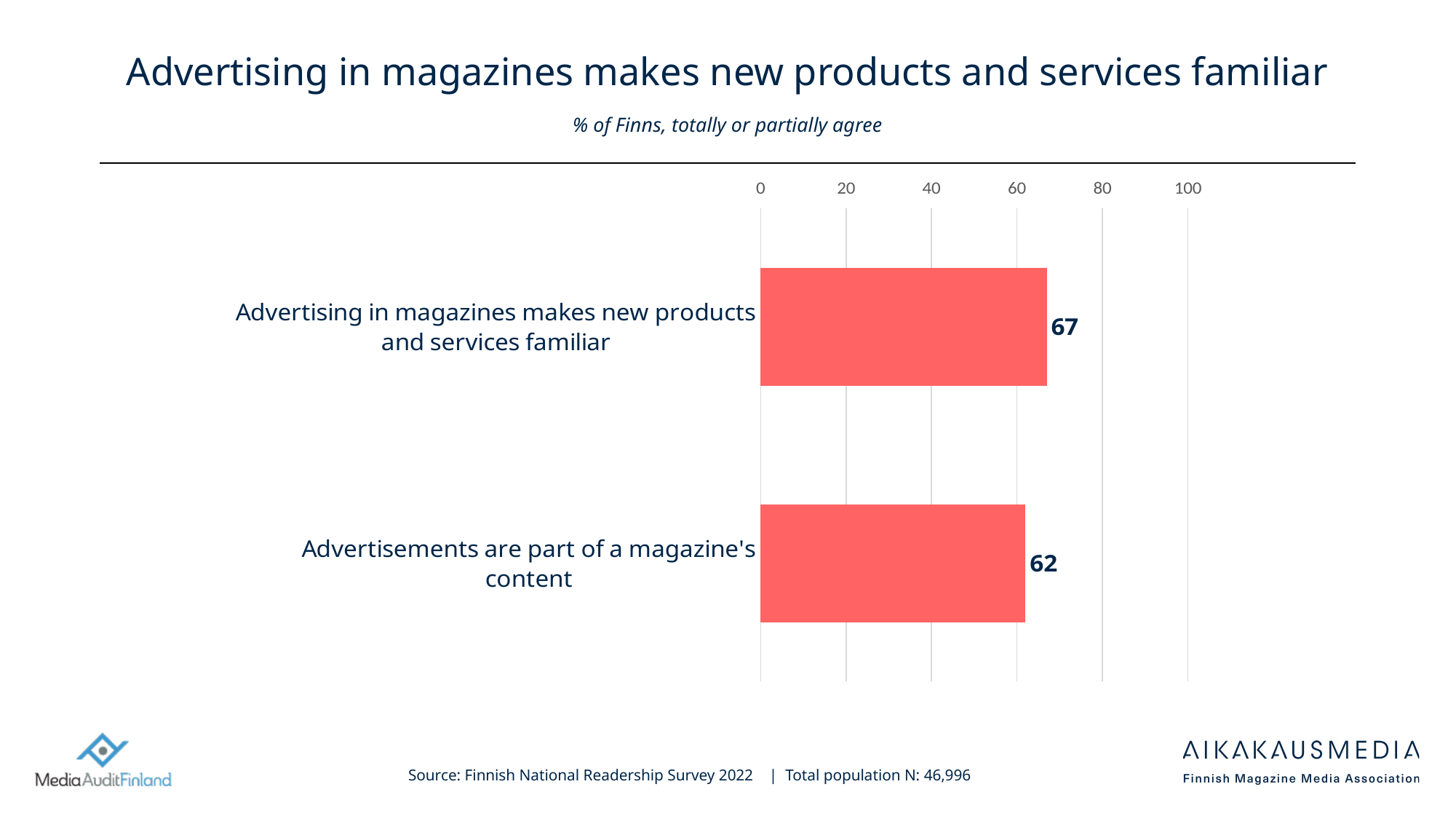
What is the title of the slide? Advertising in magazines makes new products and services familiar Is the value for "Advertisements are part of a magazine's content" greater or less than 80? less What is the maximum value shown on the chart's axis? 100 Which is larger: the value for "Advertising in magazines makes new products and services familiar" or for "Advertisements are part of a magazine's content"? Advertising in magazines makes new products and services familiar What kind of chart is shown on the slide? bar chart Which category has the lowest value? Advertisements are part of a magazine's content How many categories are shown in the chart? 2 What is the value for "Advertisements are part of a magazine's content"? 62 Is the value for "Advertising in magazines makes new products and services familiar" greater or less than 60? greater What is the value for "Advertising in magazines makes new products and services familiar"? 67 What is the difference between the values for "Advertising in magazines makes new products and services familiar" and "Advertisements are part of a magazine's content"? 5 Which category has the highest value? Advertising in magazines makes new products and services familiar